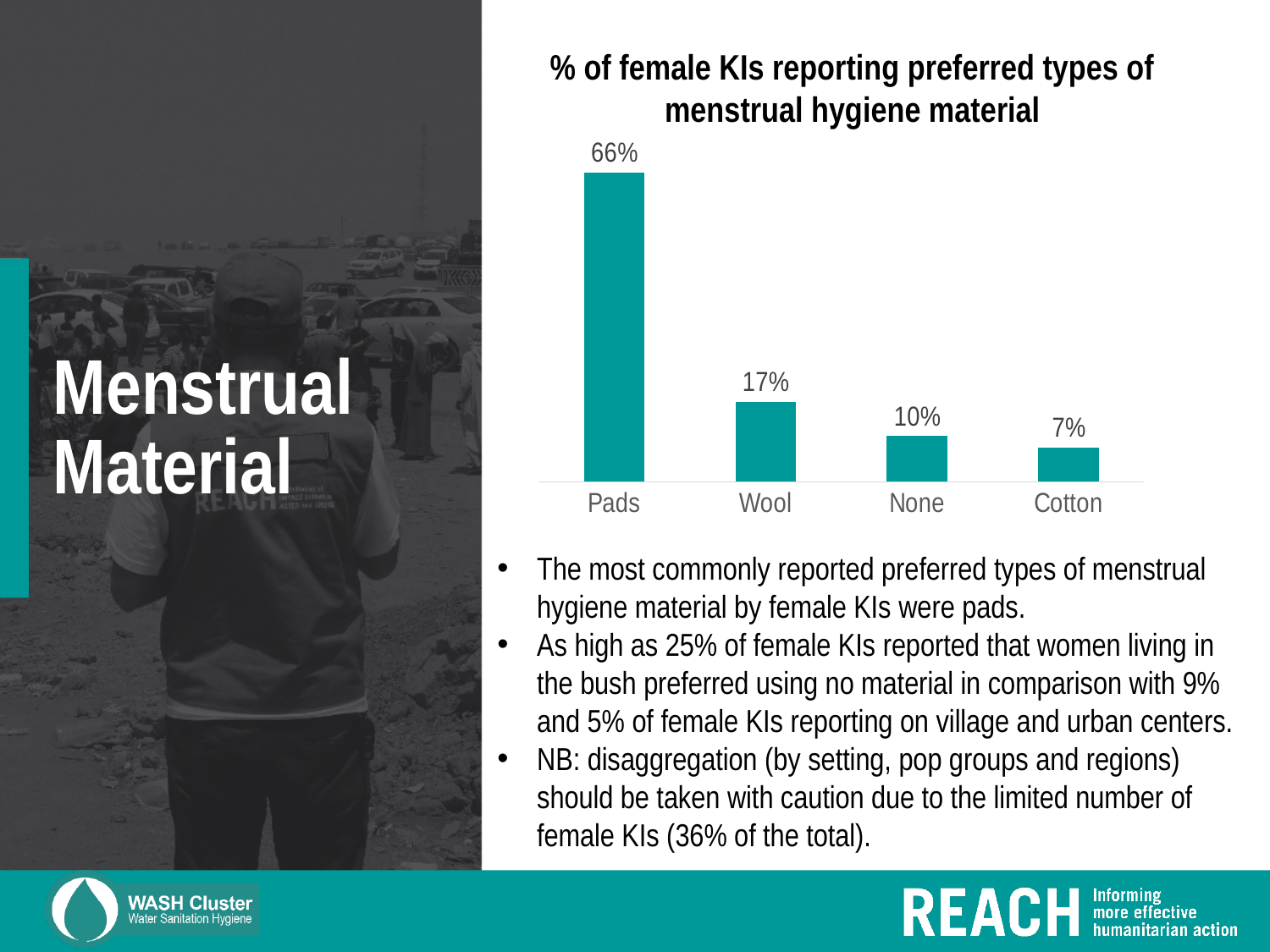
What percentage of female KIs reported None as the preferred menstrual hygiene material? 10% Which category has the highest value in the chart? Pads What type of chart is shown on the slide? Bar chart How many categories are shown in the chart? 4 Which is larger, the value for Wool or the value for None? Wool What percentage of female KIs reported pads as their preferred type of menstrual hygiene material? 66% What is the difference in percentage points between None and Cotton? 3 What is the value shown for Cotton? 7% What is the value shown for Wool in the chart? 17% What is the difference in percentage points between Pads and Wool? 49 What is the title of the chart? % of female KIs reporting preferred types of menstrual hygiene material Which category has the lowest value in the chart? Cotton